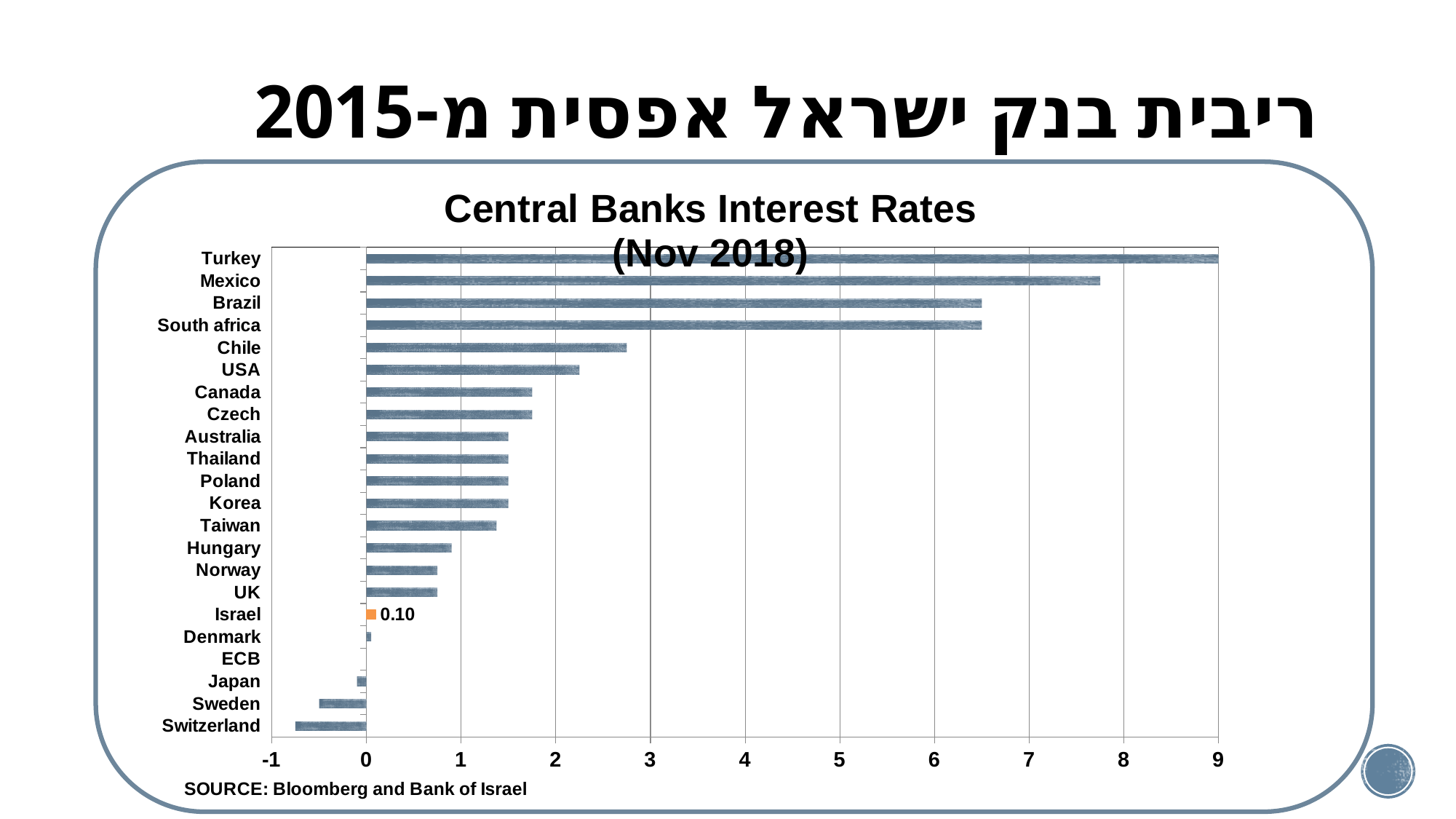
What is the interest rate shown for Israel? 0.10 What kind of chart is shown on the slide? bar chart Is the value for Hungary greater or less than 1? less Is the value for Mexico greater or less than 7? greater Is the value for USA greater or less than 2? greater Which has a higher interest rate, Chile or USA? Chile How many central banks are listed in the chart? 22 Which central bank has the highest interest rate in the chart? Turkey Which central bank has the lowest interest rate in the chart? Switzerland Which country's bar is highlighted in orange? Israel Which has a higher interest rate, Mexico or Brazil? Mexico